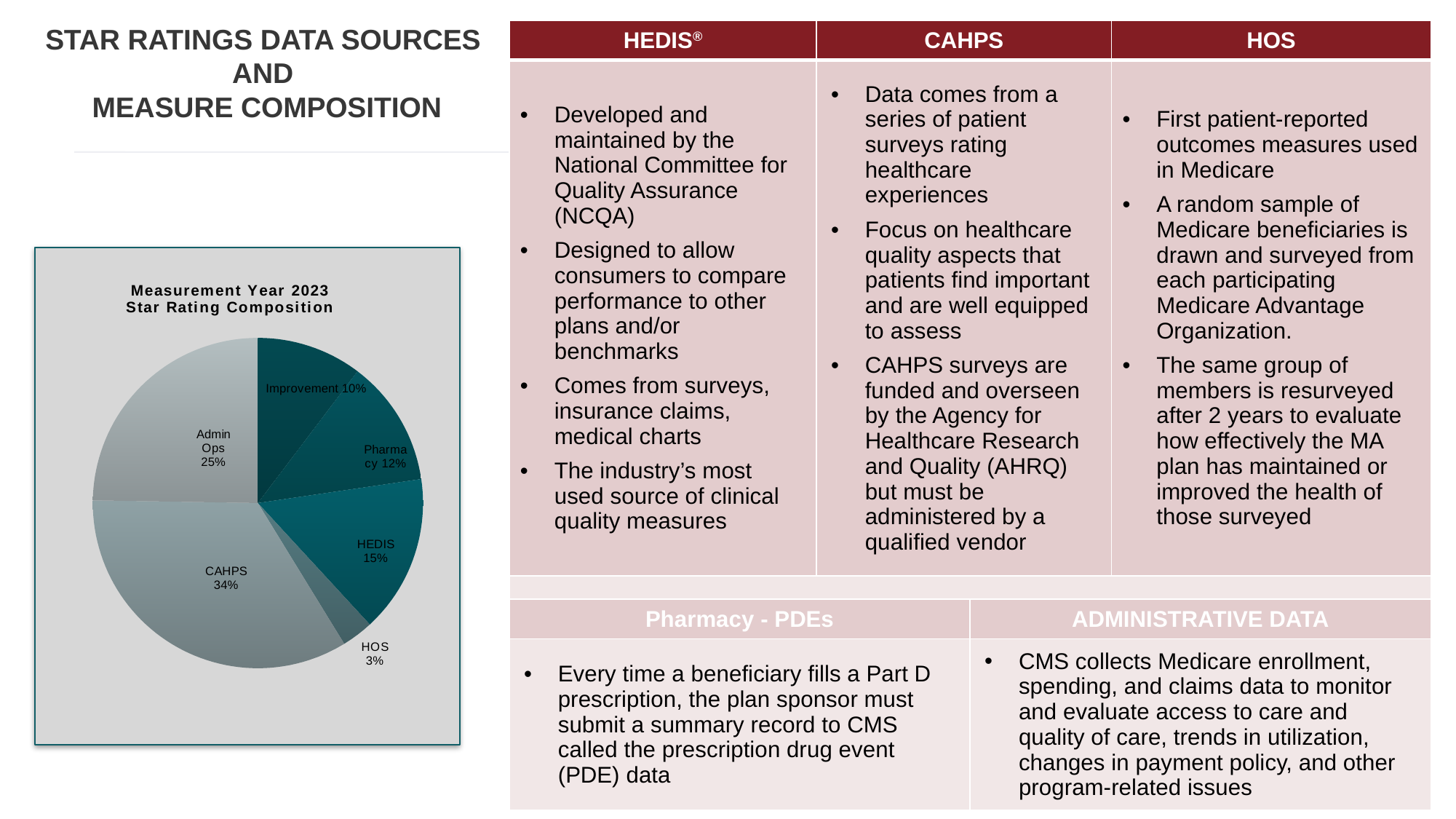
What kind of chart is shown on the slide? Pie chart What share of the pie does Admin Ops represent? 25% How many slices does the pie chart have? 6 What is the title of the chart? Measurement Year 2023 Star Rating Composition What share of the pie does CAHPS represent? 34% What is the difference in percentage points between the CAHPS slice and the Admin Ops slice? 9 Which slice of the pie is the smallest? HOS Which slice of the pie is the largest? CAHPS What share of the pie does HOS represent? 3% What share of the pie does HEDIS represent? 15% What share of the pie does Pharmacy represent? 12% Which is larger, the HEDIS slice or the Improvement slice? HEDIS